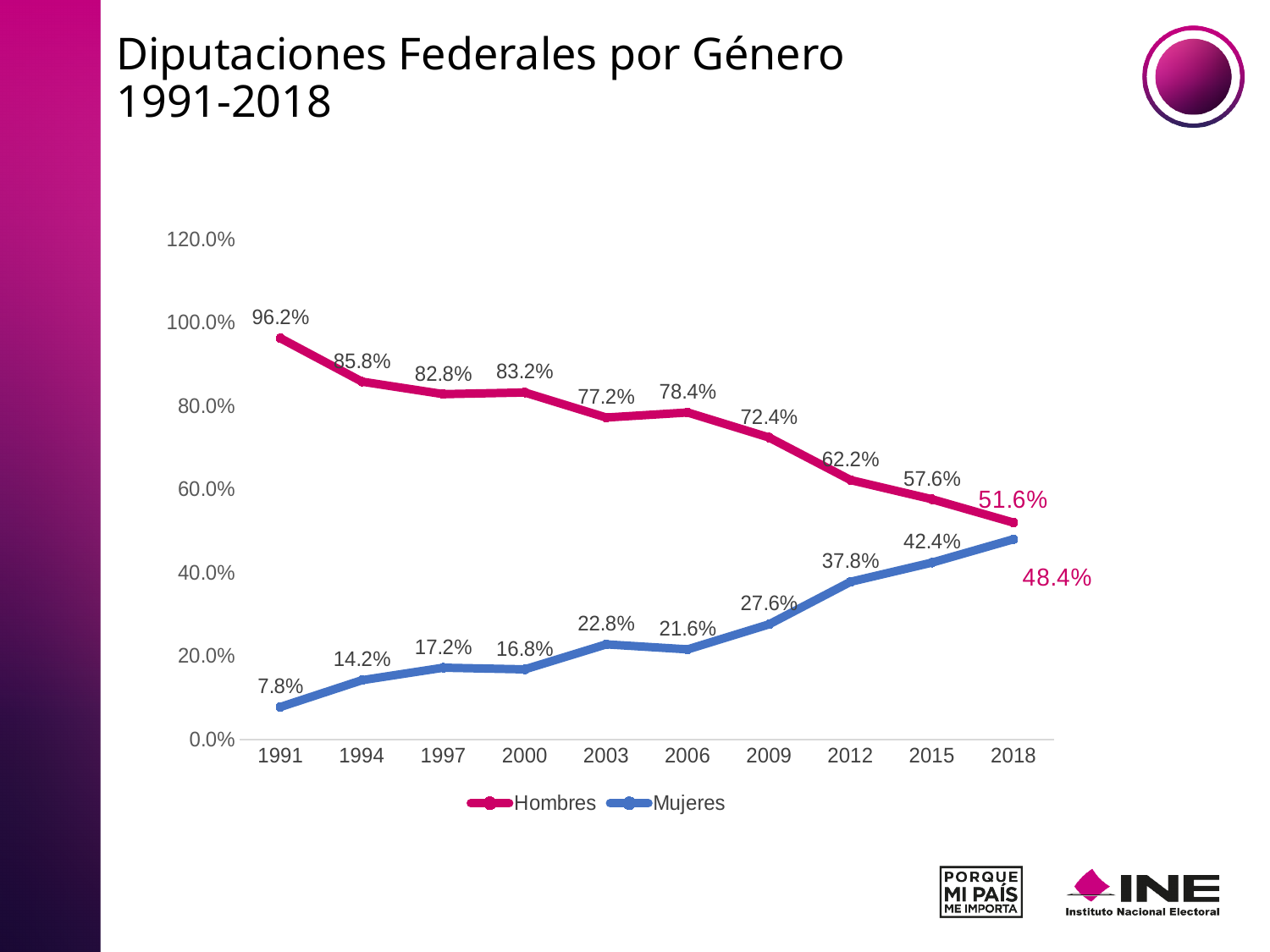
Is the value for Mujeres in 2009 greater or less than 20.0%? greater What is the difference between Hombres and Mujeres in 2018? 3.2% Which is larger in 2012, Hombres or Mujeres? Hombres How many series does the legend list? 2 Does the Hombres series rise or fall from 1991 to 2018? Fall What is the value for Mujeres in 2003? 22.8% What is the value for Mujeres in 2018? 48.4% In which year is the Hombres series at its lowest? 2018 What is the value for Hombres in 1991? 96.2% What kind of chart is shown on the slide? Line chart In which year is the Mujeres series at its lowest? 1991 How many years are shown on the x axis? 10